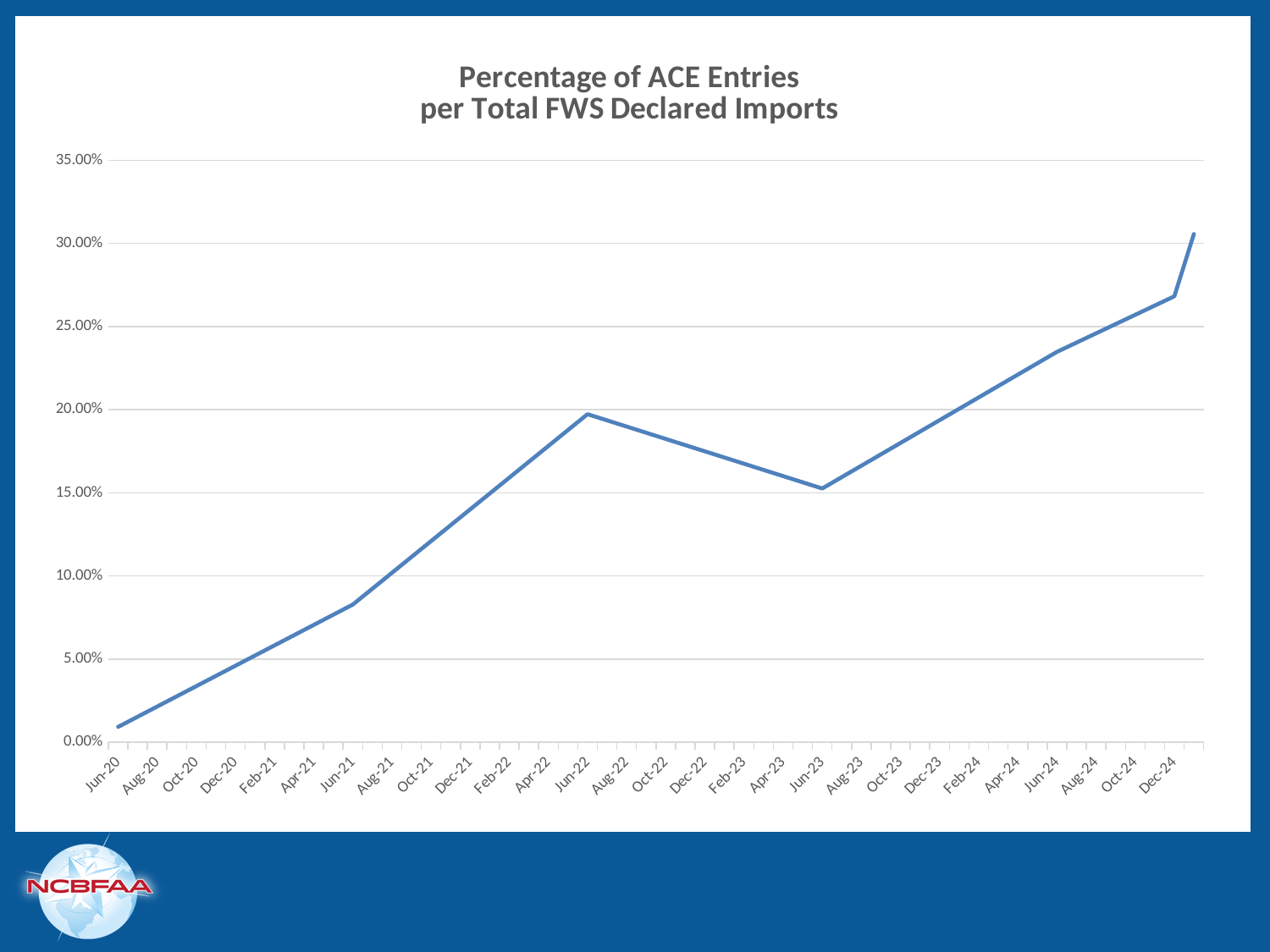
Is the value for Jun-23 greater or less than 20.00%? less Which labelled month on the x axis has the lowest value? Jun-20 Is the value for Dec-24 greater or less than 25.00%? greater Which of the labelled months, Jun-21 or Jun-22, has the higher value? Jun-22 Does the line rise or fall between Jun-22 and Jun-23? fall Which of the labelled months, Jun-22 or Jun-23, has the higher value? Jun-22 Is the value for Jun-22 greater or less than 15.00%? greater What is the title of the chart? Percentage of ACE Entries per Total FWS Declared Imports What kind of chart is shown on the slide? line chart Does the line overall rise or fall from Jun-20 to the end of the series? rise